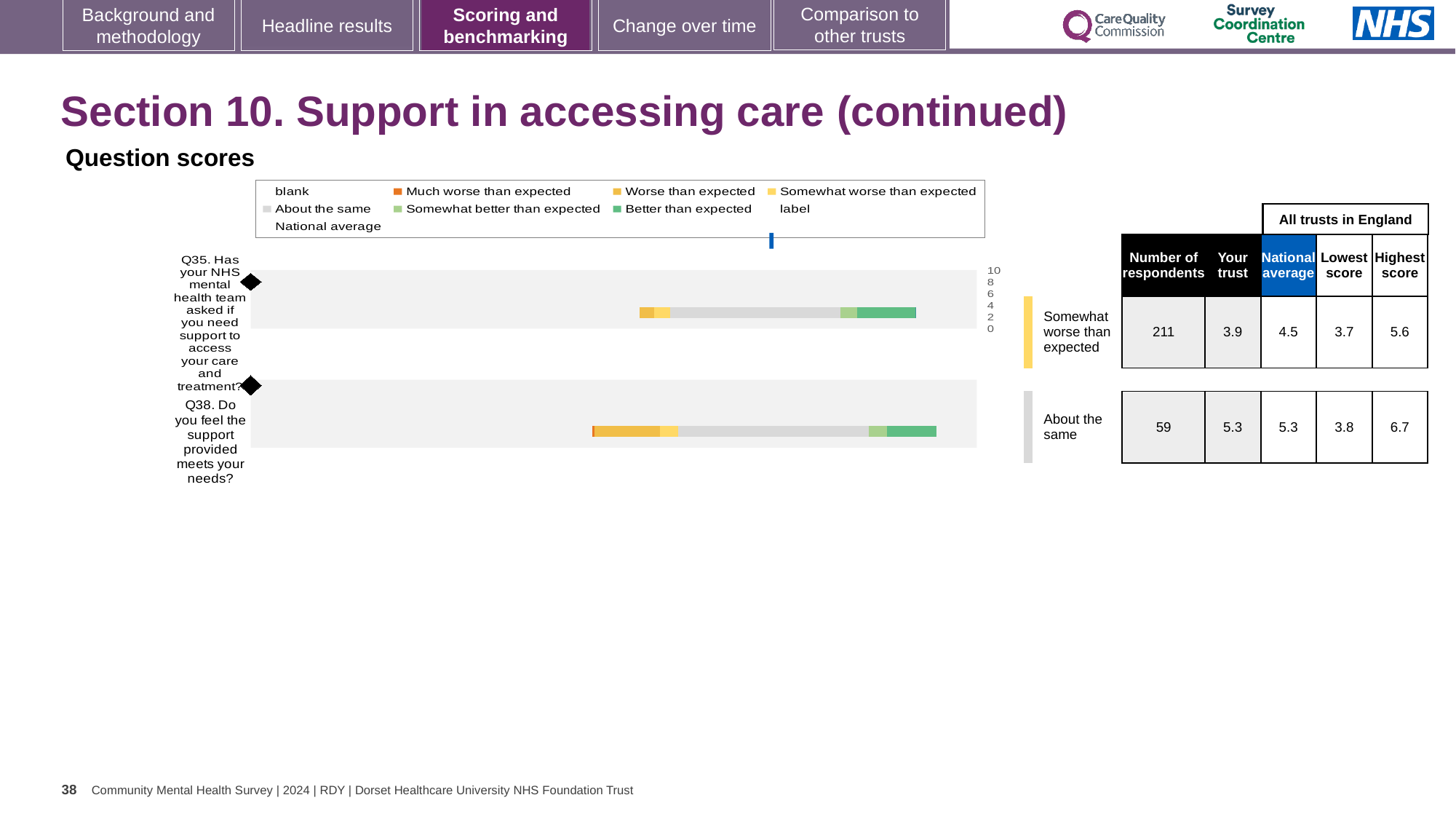
What kind of chart is used to show the question scores on this slide? bar chart What benchmark category is shown for Q38? About the same What is the national average score for Q38 (Do you feel the support provided meets your needs?)? 5.3 How many respondents answered Q38? 59 Which question has the higher 'Your trust' score, Q35 or Q38? Q38 How many questions are plotted in the question scores chart? 2 How many respondents answered Q35? 211 What is the difference between the national average and the 'Your trust' score for Q35? 0.6 What is the 'Your trust' score for Q35 (Has your NHS mental health team asked if you need support to access your care and treatment?)? 3.9 What benchmark category is shown for Q35? Somewhat worse than expected What is the difference between the highest score and the lowest score across all trusts in England for Q38? 2.9 What is the highest score among all trusts in England for Q35? 5.6